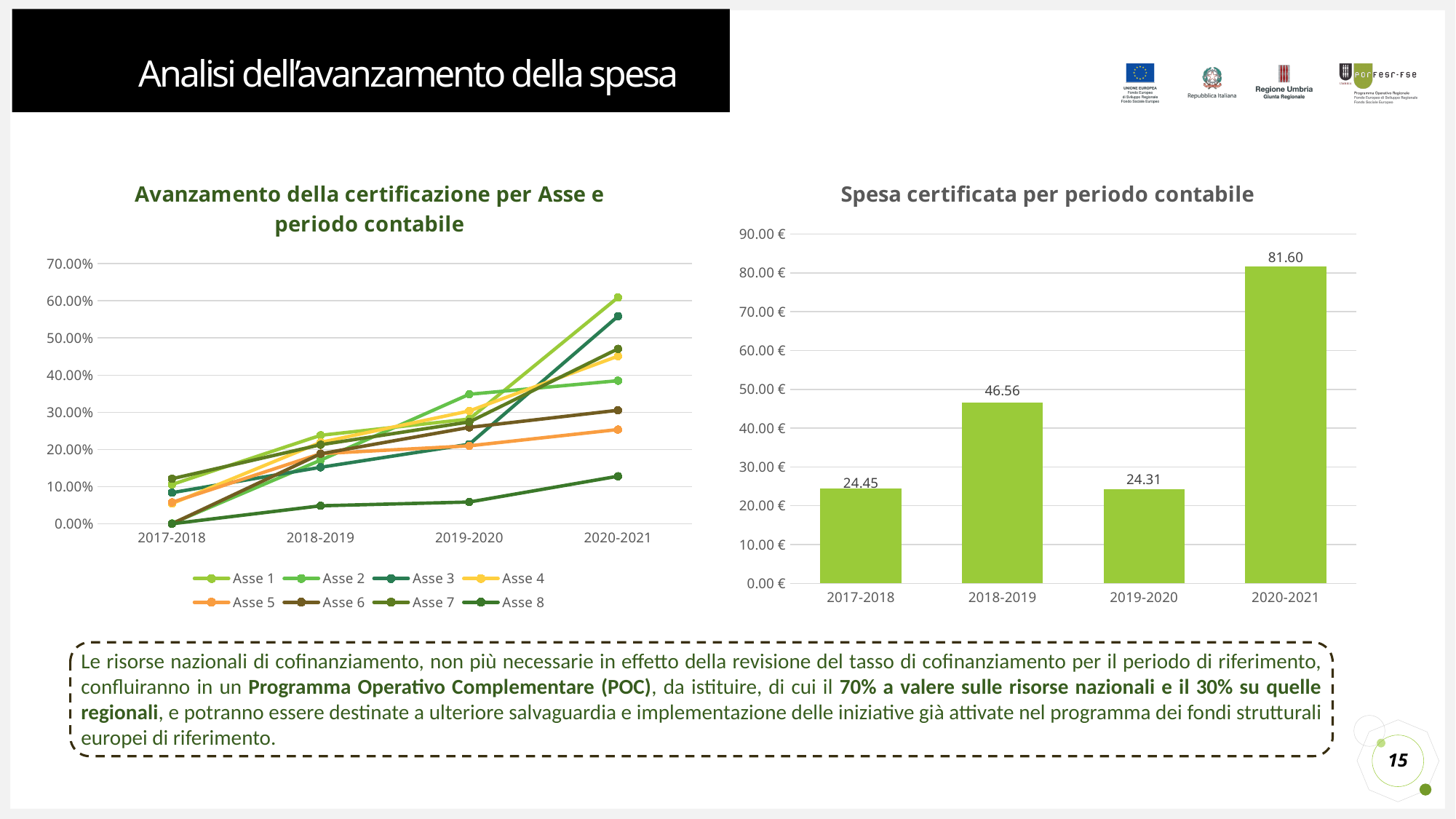
In the 'Avanzamento della certificazione per Asse e periodo contabile' chart, which series has the lowest value in 2020-2021? Asse 8 In the 'Avanzamento della certificazione per Asse e periodo contabile' chart, is the value for Asse 8 in 2020-2021 greater or less than 20.00%? less In the 'Spesa certificata per periodo contabile' chart, what is the difference between the values for 2020-2021 and 2018-2019? 35.04 What kind of chart is 'Avanzamento della certificazione per Asse e periodo contabile'? line chart In the 'Spesa certificata per periodo contabile' chart, which period has the highest value? 2020-2021 In the 'Spesa certificata per periodo contabile' chart, which is larger: the value for 2018-2019 or the value for 2019-2020? 2018-2019 In the 'Spesa certificata per periodo contabile' chart, what is the value for 2018-2019? 46.56 In the 'Spesa certificata per periodo contabile' chart, what is the value for 2020-2021? 81.60 In the 'Spesa certificata per periodo contabile' chart, how many periods are shown? 4 What kind of chart is 'Spesa certificata per periodo contabile'? bar chart In the 'Avanzamento della certificazione per Asse e periodo contabile' chart, how many series does the legend list? 8 In the 'Spesa certificata per periodo contabile' chart, which period has the lowest value? 2019-2020